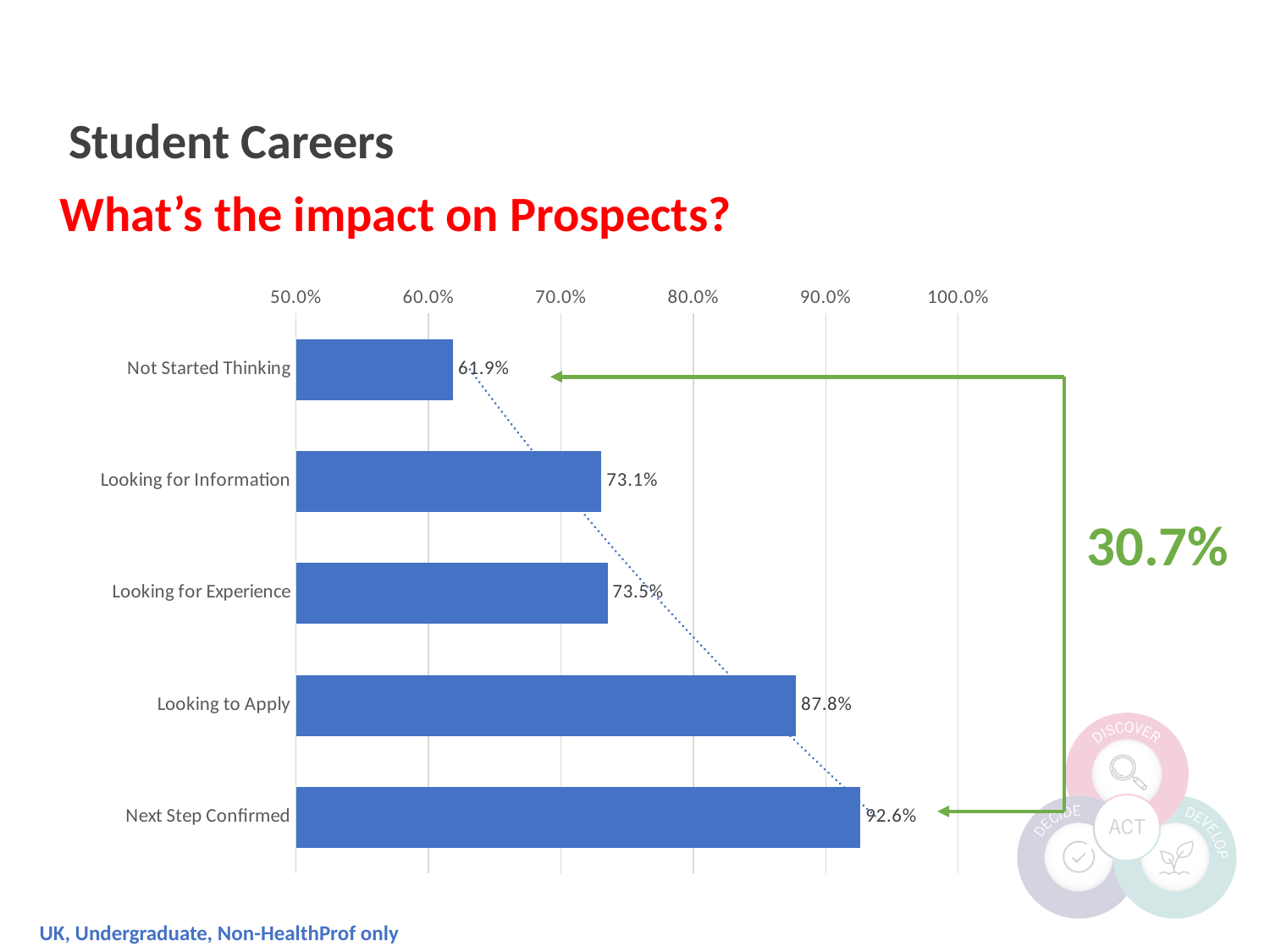
What is the value for Next Step Confirmed? 92.6% Which category has the lowest value? Not Started Thinking What is the value for Looking to Apply? 87.8% What kind of chart is shown on the slide? bar chart What is the value for Looking for Experience? 73.5% Is the value for Looking to Apply greater or less than 80.0%? greater How many categories are shown in the chart? 5 What is the difference between the values for Looking to Apply and Looking for Experience? 14.3% Which is larger, the value for Looking to Apply or the value for Looking for Information? Looking to Apply What is the difference between the values for Next Step Confirmed and Not Started Thinking? 30.7% What is the value for Not Started Thinking? 61.9% Which category has the highest value? Next Step Confirmed